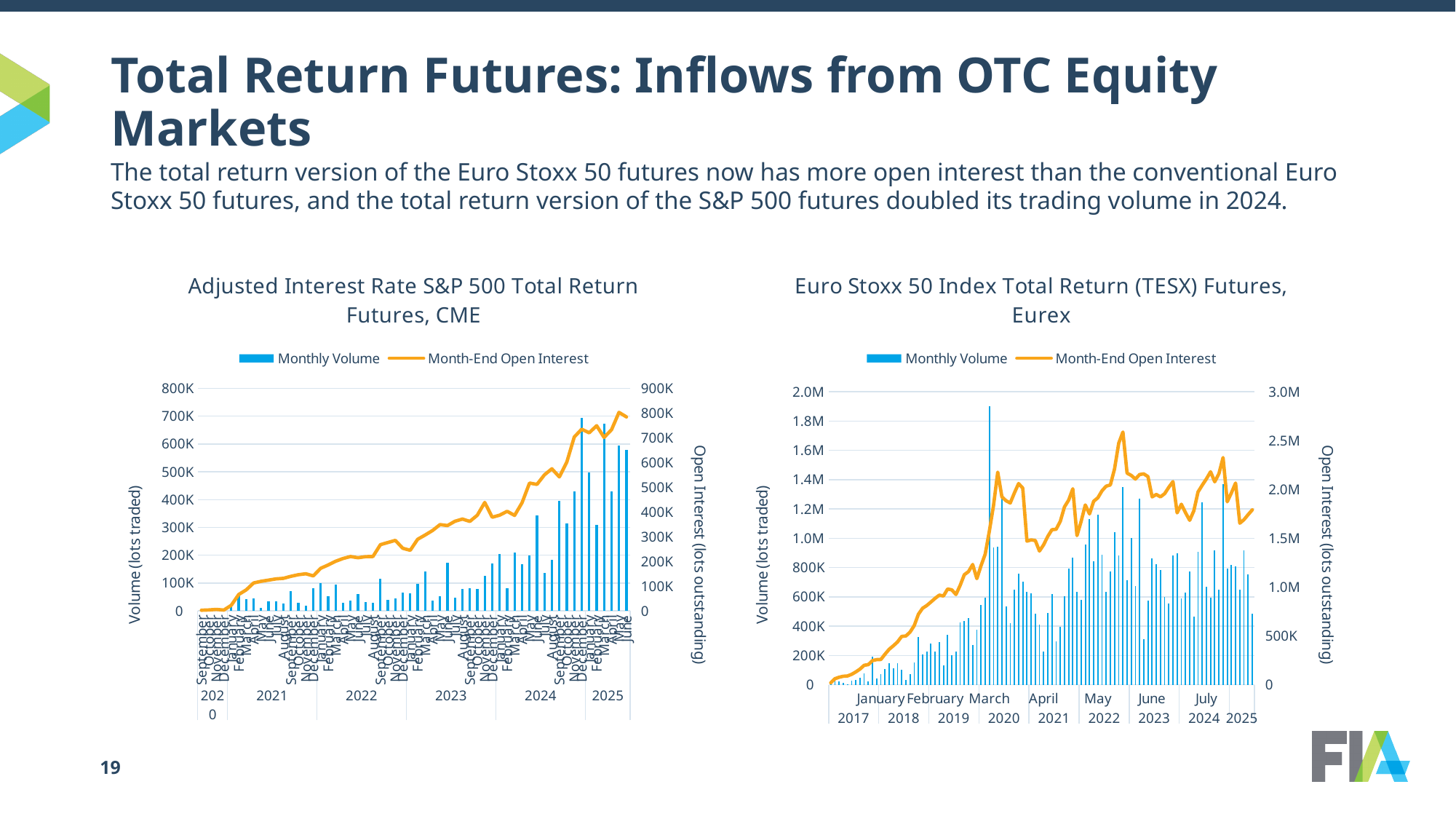
In the left chart (S&P 500 Total Return Futures, CME), which series is drawn as a line? Month-End Open Interest In the left chart (S&P 500 Total Return Futures, CME), is the Month-End Open Interest value at the end of the series (June 2025) greater or less than 700K? greater In the right chart (Euro Stoxx 50 TESX Futures, Eurex), is the tallest Monthly Volume bar greater or less than 1.6M? greater How many series does the legend of the right chart, 'Euro Stoxx 50 Index Total Return (TESX) Futures, Eurex', list? 2 In the right chart (Euro Stoxx 50 TESX Futures, Eurex), is the peak of the Month-End Open Interest line greater or less than 2.0M? greater In the left chart (S&P 500 Total Return Futures, CME), does the Month-End Open Interest line generally rise or fall from 2020 to 2025? Rise In the right chart (Euro Stoxx 50 TESX Futures, Eurex), is the Month-End Open Interest higher at the end of the series (2025) or at the start (2017)? At the end (2025) In the right chart (Euro Stoxx 50 TESX Futures, Eurex), what colour are the Monthly Volume bars? Blue In the right chart (Euro Stoxx 50 TESX Futures, Eurex), does the Month-End Open Interest line overall rise or fall from 2017 to 2025? Rise What kind of chart is the left chart, 'Adjusted Interest Rate S&P 500 Total Return Futures, CME'? A combined bar and line chart In the right chart (Euro Stoxx 50 TESX Futures, Eurex), in which year does the tallest Monthly Volume bar appear? 2020